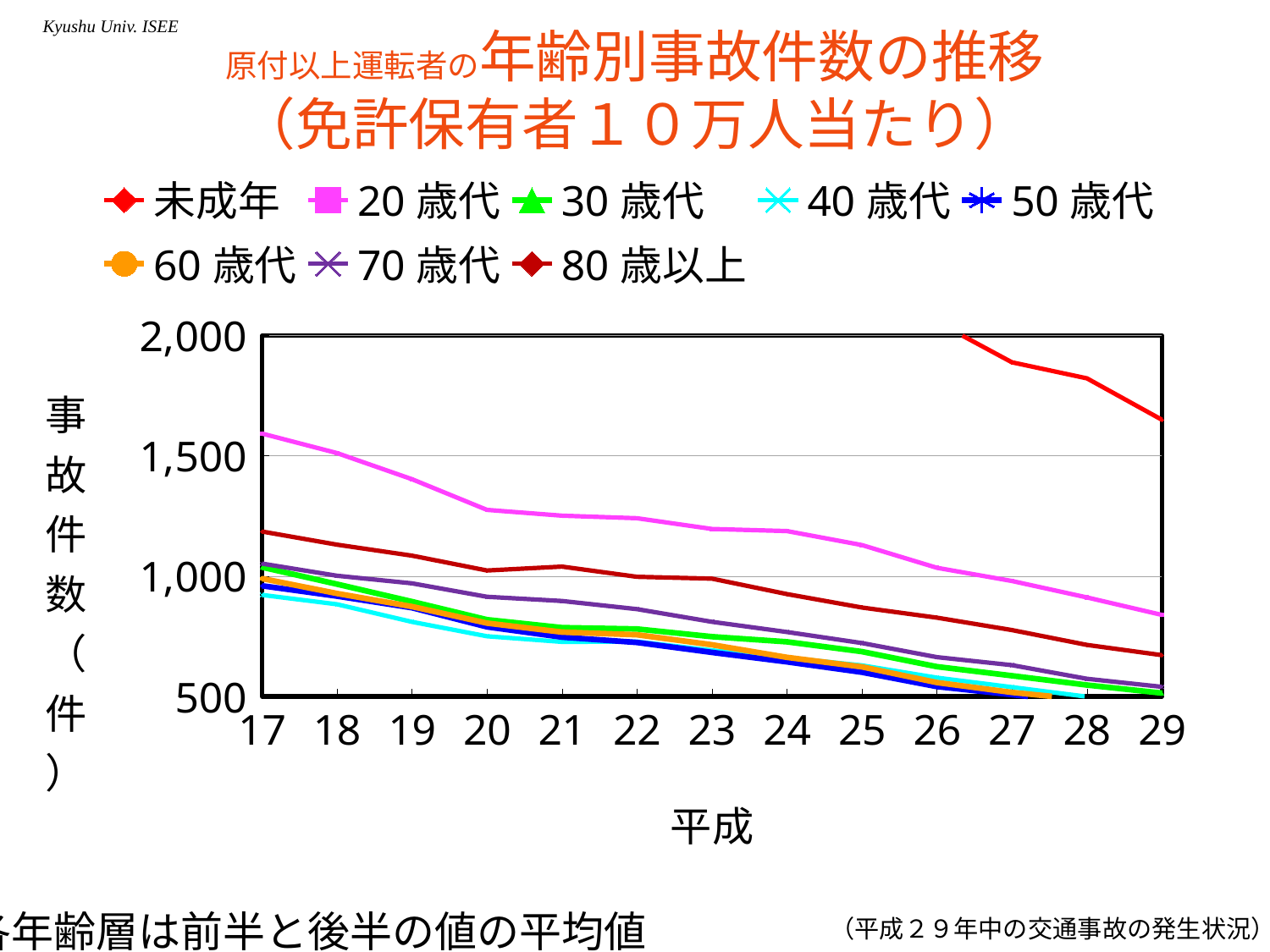
Does the value for 80歳以上 rise or fall overall from 平成17 to 平成29? fall Is the value for 80歳以上 in 平成29 greater or less than 1,000? less What kind of chart is shown on the slide? line chart What is the label of the x axis? 平成 Is the value for 40歳代 in 平成17 greater or less than 1,000? less How many series does the legend list? 8 In 平成29, which is larger: the value for 20歳代 or the value for 80歳以上? 20歳代 Does the value for 20歳代 rise or fall from 平成17 to 平成29? fall Which series has the highest value in 平成29? 未成年 Is the value for 20歳代 in 平成17 greater or less than 1,500? greater How many years (x-axis points) are plotted on the chart? 13